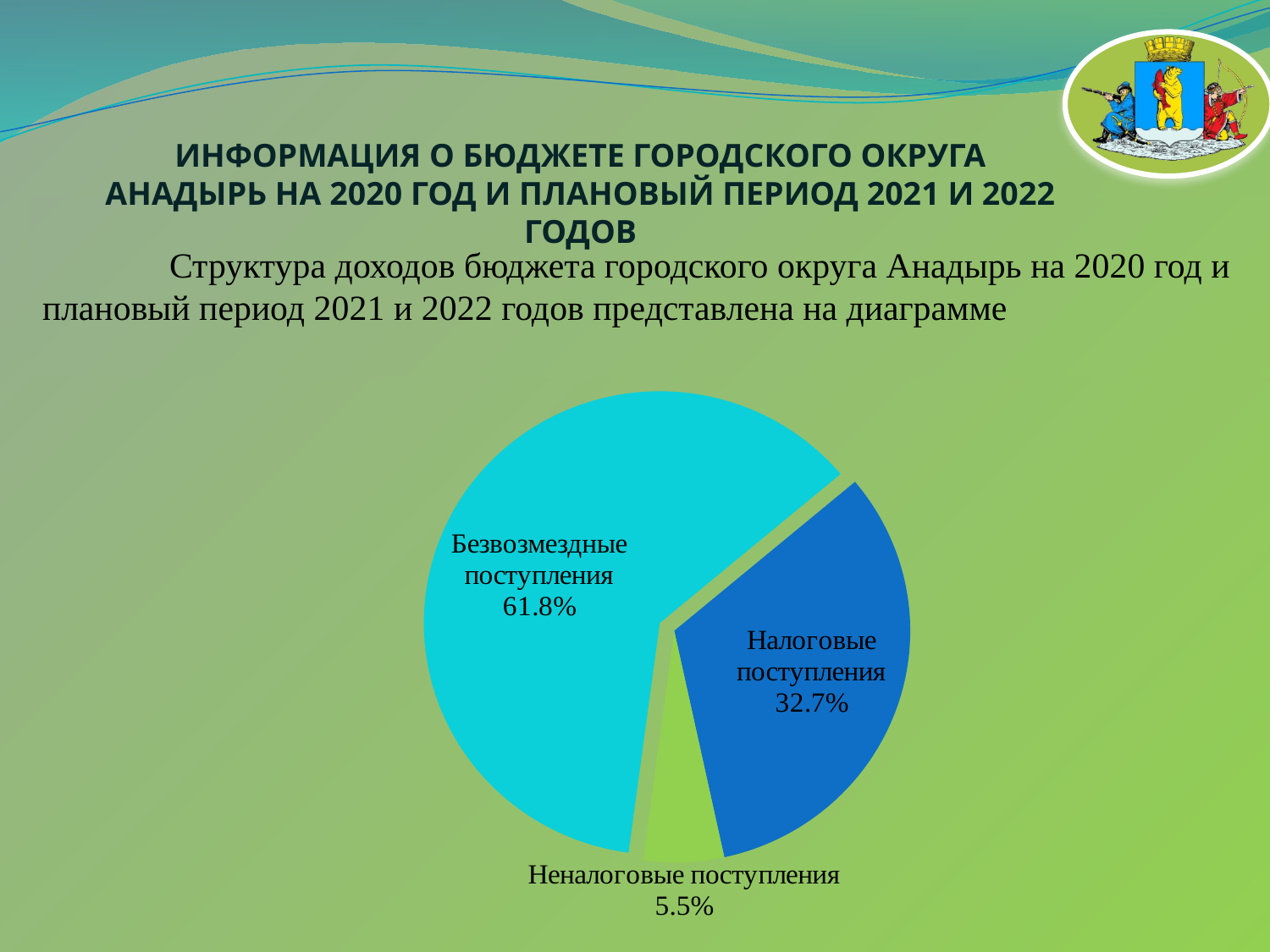
What kind of chart is shown on the slide? Pie chart What share of the pie does Неналоговые поступления hold? 5.5% Which category has the smallest slice of the pie? Неналоговые поступления What share of the pie does Безвозмездные поступления hold? 61.8% Which is larger: Налоговые поступления or Неналоговые поступления? Налоговые поступления How many categories are shown in the pie chart? 3 What is the difference in percentage points between Налоговые поступления and Неналоговые поступления? 27.2 Which is larger: Безвозмездные поступления or Налоговые поступления? Безвозмездные поступления What share of the pie does Налоговые поступления hold? 32.7% Which category has the largest slice of the pie? Безвозмездные поступления What colour is the slice for Налоговые поступления? Blue What is the difference in percentage points between Безвозмездные поступления and Налоговые поступления? 29.1